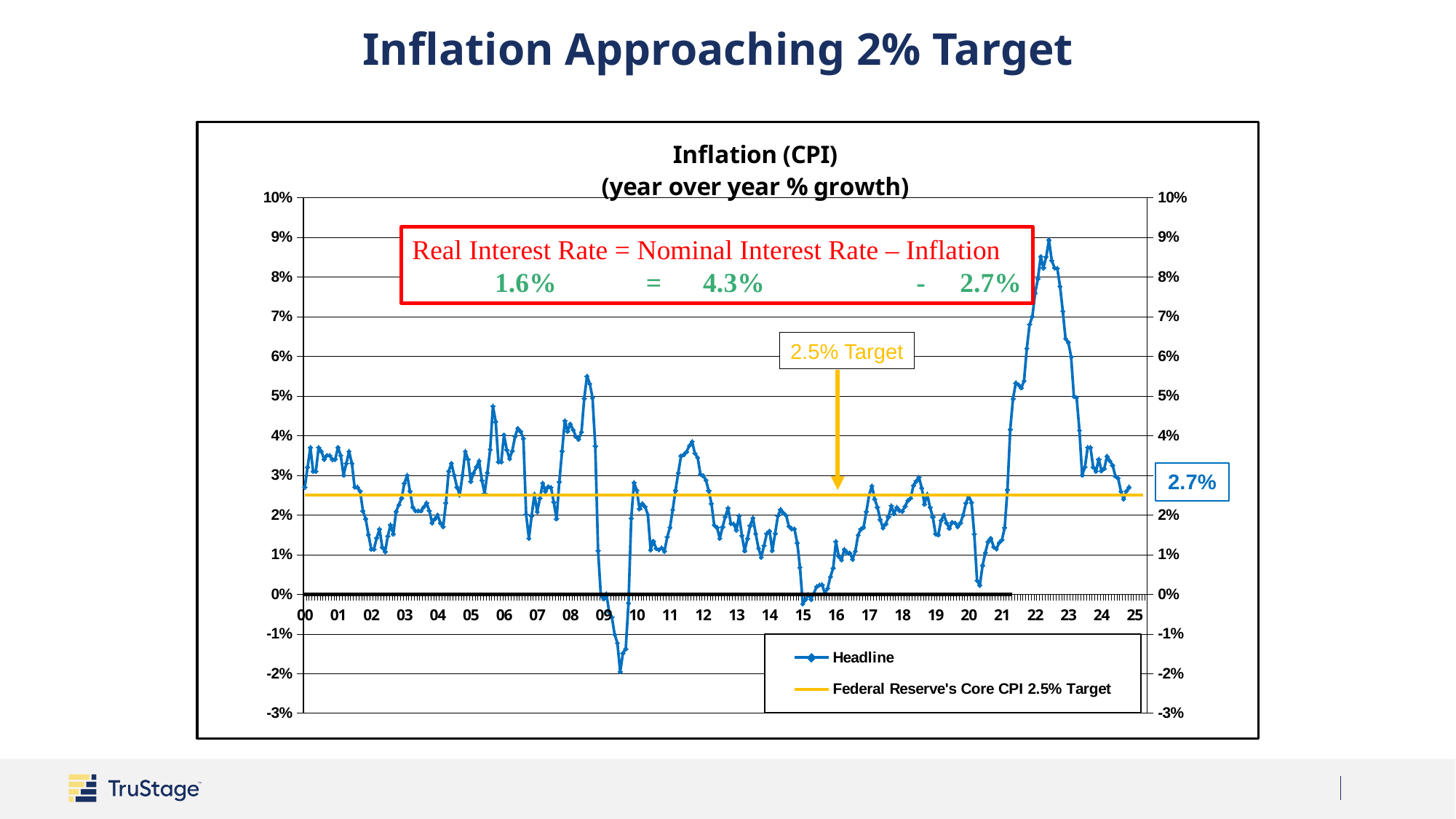
In which year does Headline inflation reach its lowest point? 2009 In which year does Headline inflation reach its highest point? 2022 What is the value of the Federal Reserve's Core CPI target line? 2.5% Is the Headline inflation value in 2015 greater or less than 1%? less Does Headline inflation rise or fall from its 2022 peak to 2024? fall Is the lowest Headline inflation value in 2009 greater or less than -1%? less Is the peak Headline inflation value in 2022 greater or less than 8%? greater By how much does the latest Headline inflation value of 2.7% exceed the 2.5% target? 0.2% What kind of chart is shown on the slide? line chart What is the most recent Headline inflation value labeled on the chart? 2.7% Which is larger, the latest Headline inflation value or the Federal Reserve's 2.5% target? the latest Headline value (2.7%) How many series does the legend list? 2